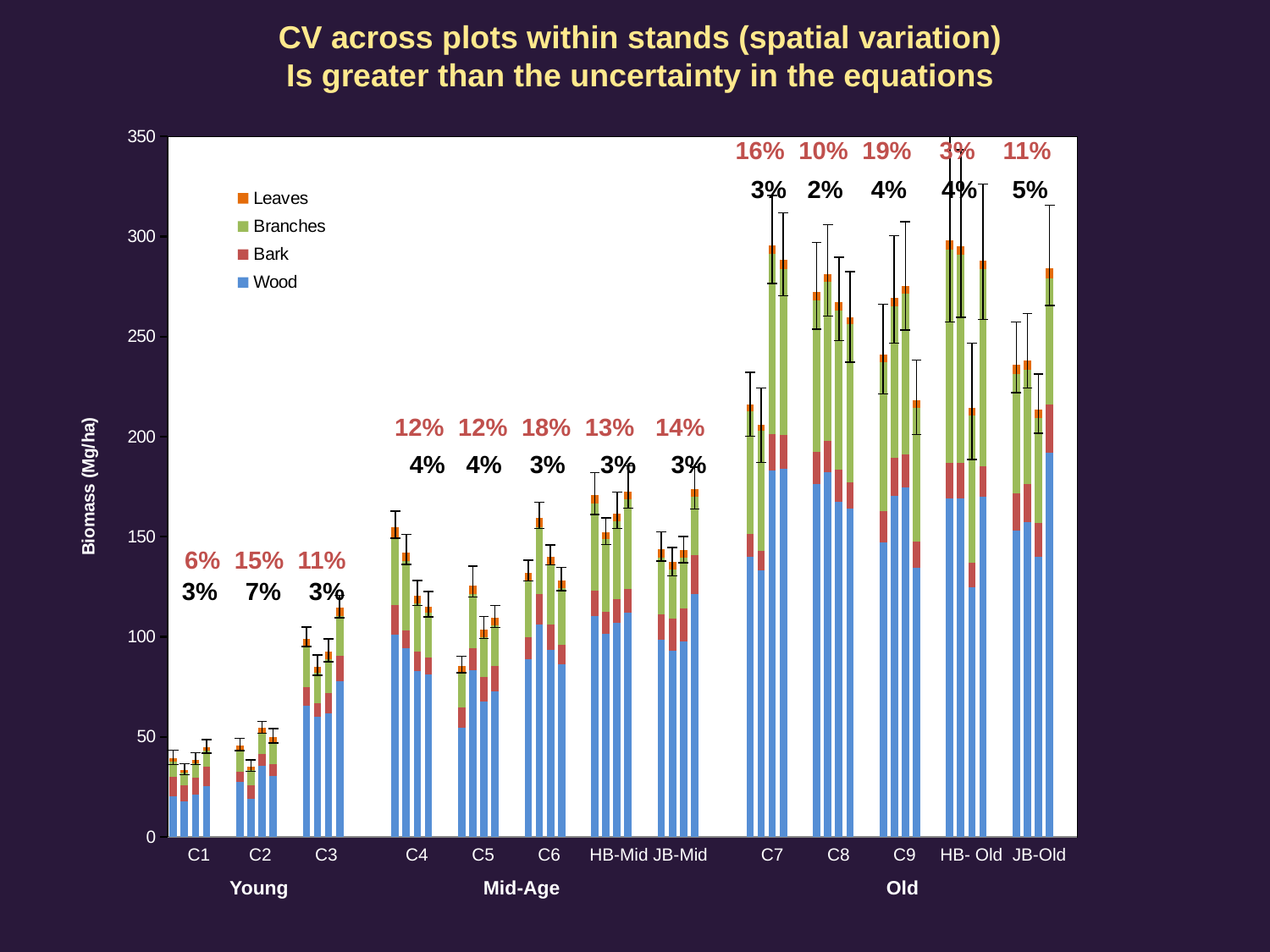
What type of chart is shown on the slide? Stacked bar chart What is the label of the y axis? Biomass (Mg/ha) What is the red CV percentage shown above the C9 stand? 19% How many stand categories are labelled along the x axis? 13 Are the total biomass values for the C1 bars greater or less than 50 Mg/ha? less Which stand has taller stacked bars, C1 or C8? C8 What is the black percentage shown above the C2 stand? 7% Which stand has the highest red CV percentage? C9 How many series does the legend list? 4 Which stand has the lowest red CV percentage? HB- Old What are the four series listed in the legend? Leaves, Branches, Bark, Wood Are the total biomass values for the C8 bars greater or less than 250 Mg/ha? greater